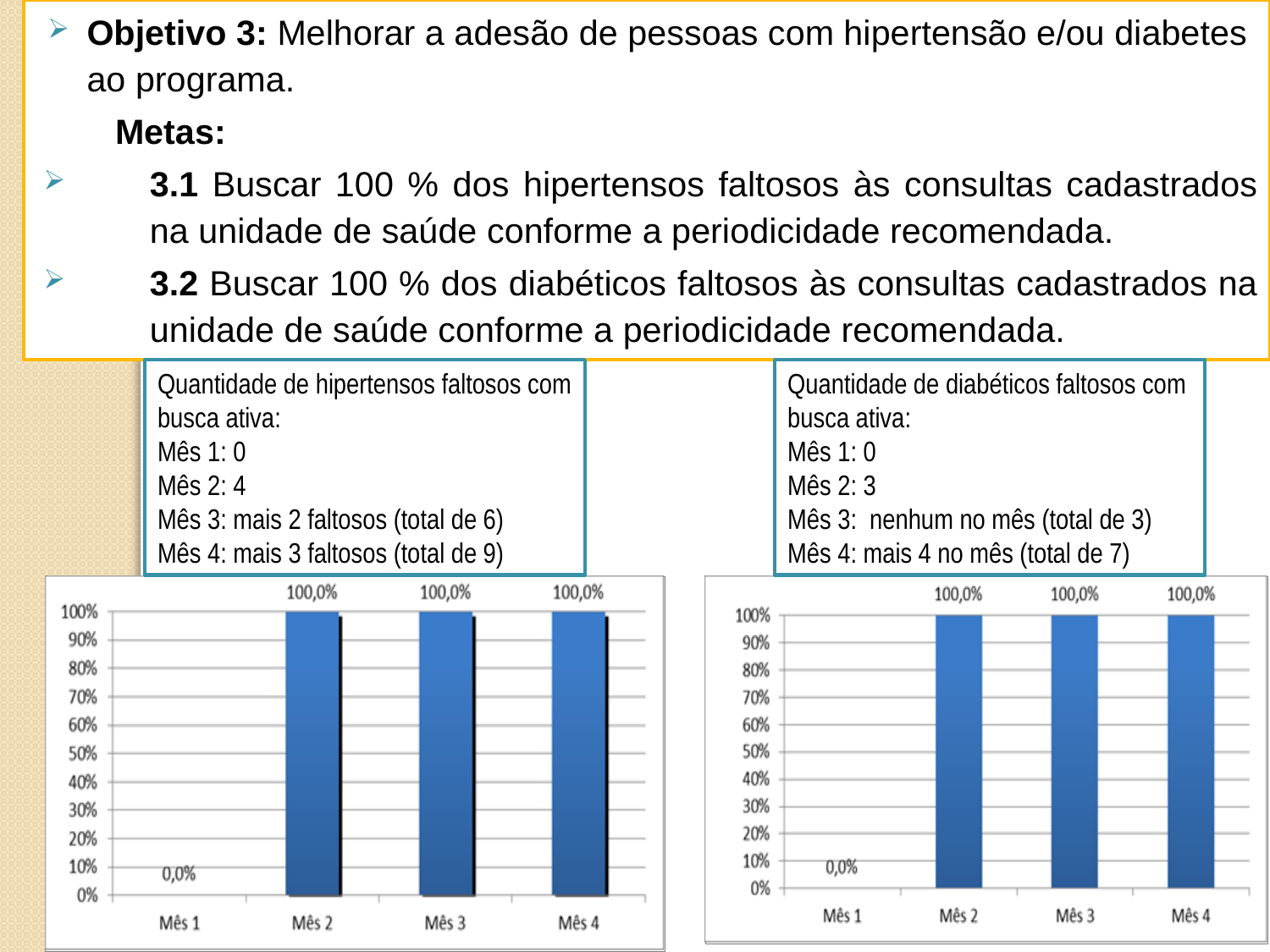
In the right chart (diabéticos faltosos), which is larger, the value for Mês 3 or the value for Mês 1? Mês 3 In the left chart (hipertensos faltosos), which month has the lowest value? Mês 1 In the right chart (diabéticos faltosos), what is the value for Mês 4? 100,0% In the left chart (hipertensos faltosos), what is the difference between the values for Mês 2 and Mês 1? 100,0% In the right chart (diabéticos faltosos), what is the value for Mês 1? 0,0% In the left chart (hipertensos faltosos), what is the value for Mês 2? 100,0% How many months (categories) are shown on the x axis of the left chart (hipertensos faltosos)? 4 What kind of chart is the right chart (diabéticos faltosos)? Bar chart In the left chart (hipertensos faltosos), what is the value for Mês 1? 0,0% In the right chart (diabéticos faltosos), which month has the lowest value? Mês 1 In the left chart (hipertensos faltosos), do the values rise or fall from Mês 1 to Mês 2? Rise In the right chart (diabéticos faltosos), is the value for Mês 2 greater or less than 50%? greater